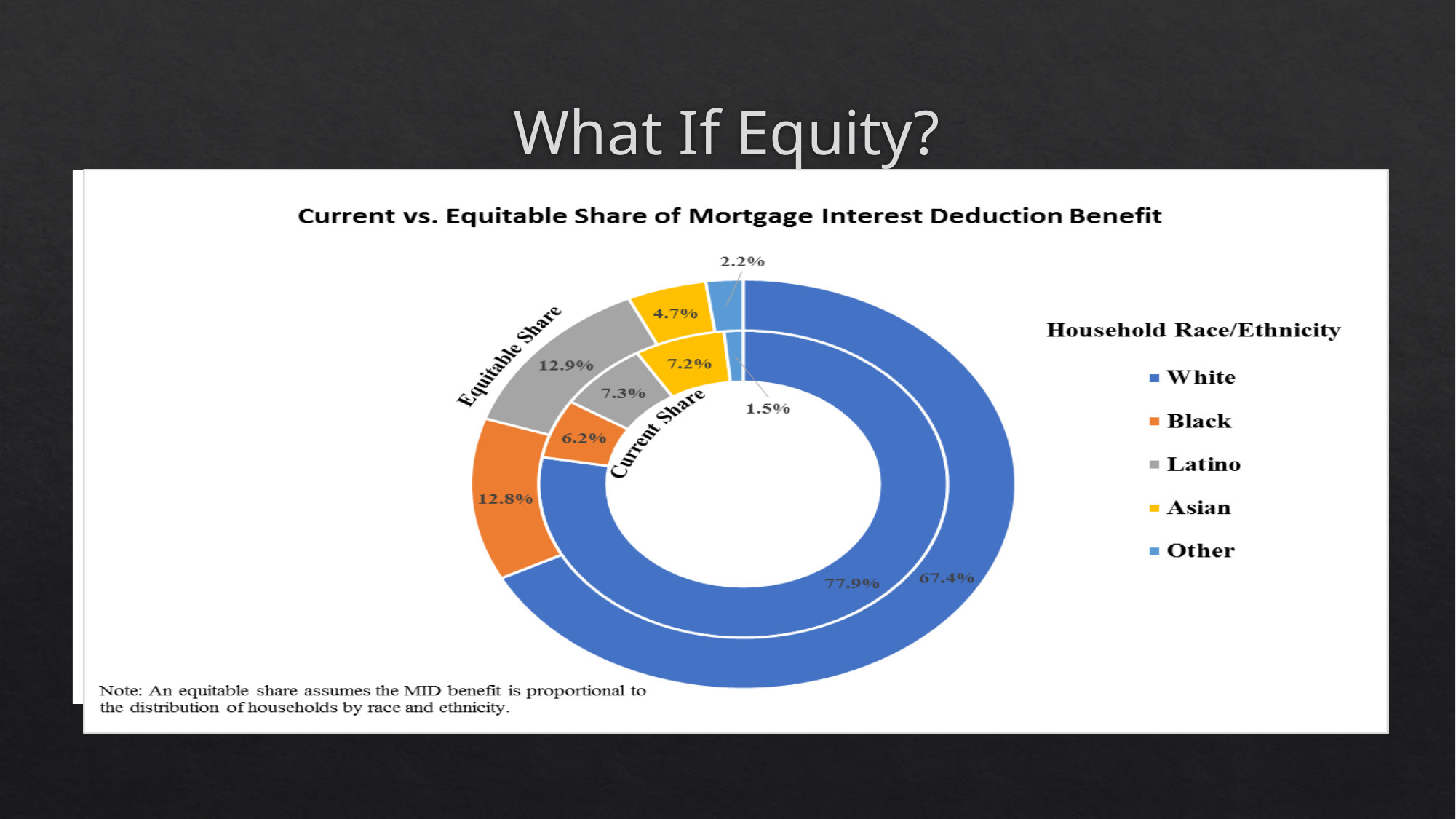
What is the title of the chart? Current vs. Equitable Share of Mortgage Interest Deduction Benefit What is the Current Share of the mortgage interest deduction benefit for White households? 77.9% How many race/ethnicity groups does the legend list? 5 What is the Equitable Share for Black households? 12.8% What kind of chart is shown on the slide? Doughnut chart Which is larger for Black households, the Current Share or the Equitable Share? Equitable Share What is the Equitable Share for Asian households? 4.7% What is the difference between the Current Share and the Equitable Share for White households? 10.5% What is the Current Share for Latino households? 7.3% What is the Current Share for Other households? 1.5% Which race/ethnicity group has the smallest Equitable Share? Other Which race/ethnicity group has the largest Current Share? White